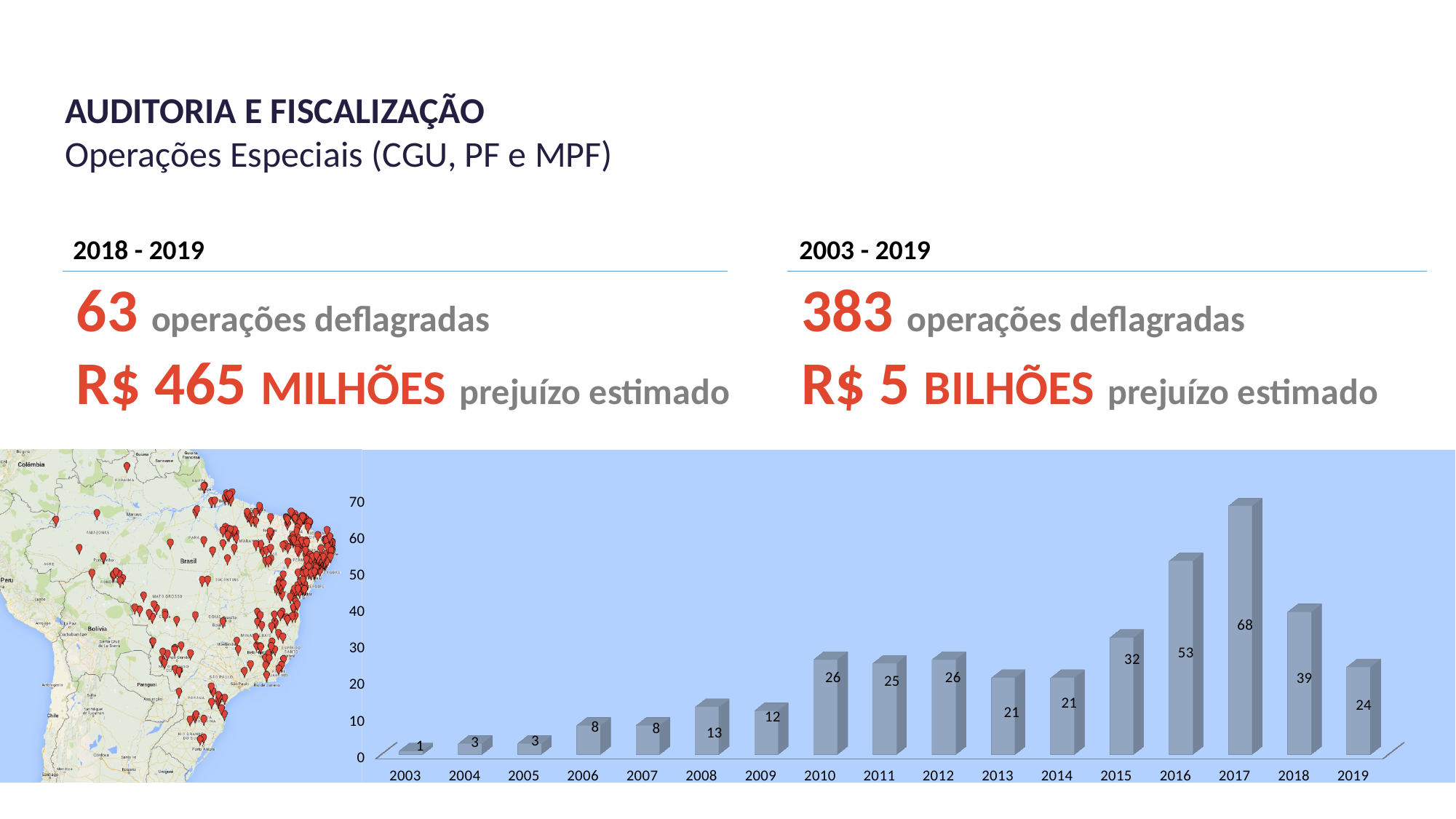
What is the difference between the values for 2016 and 2015 in the bar chart? 21 What kind of chart is shown at the bottom right of the slide? bar chart Which year has a larger value in the bar chart, 2018 or 2019? 2018 Which year has a larger value in the bar chart, 2009 or 2010? 2010 How many years are shown on the x axis of the bar chart? 17 Which year has the highest value in the bar chart? 2017 What is the value shown for 2019 in the bar chart? 24 Which year has the lowest value in the bar chart? 2003 What is the difference between the values for 2017 and 2018 in the bar chart? 29 What is the value shown for 2017 in the bar chart? 68 Do the values in the bar chart generally rise or fall from 2003 to 2017? rise What is the value shown for 2010 in the bar chart? 26